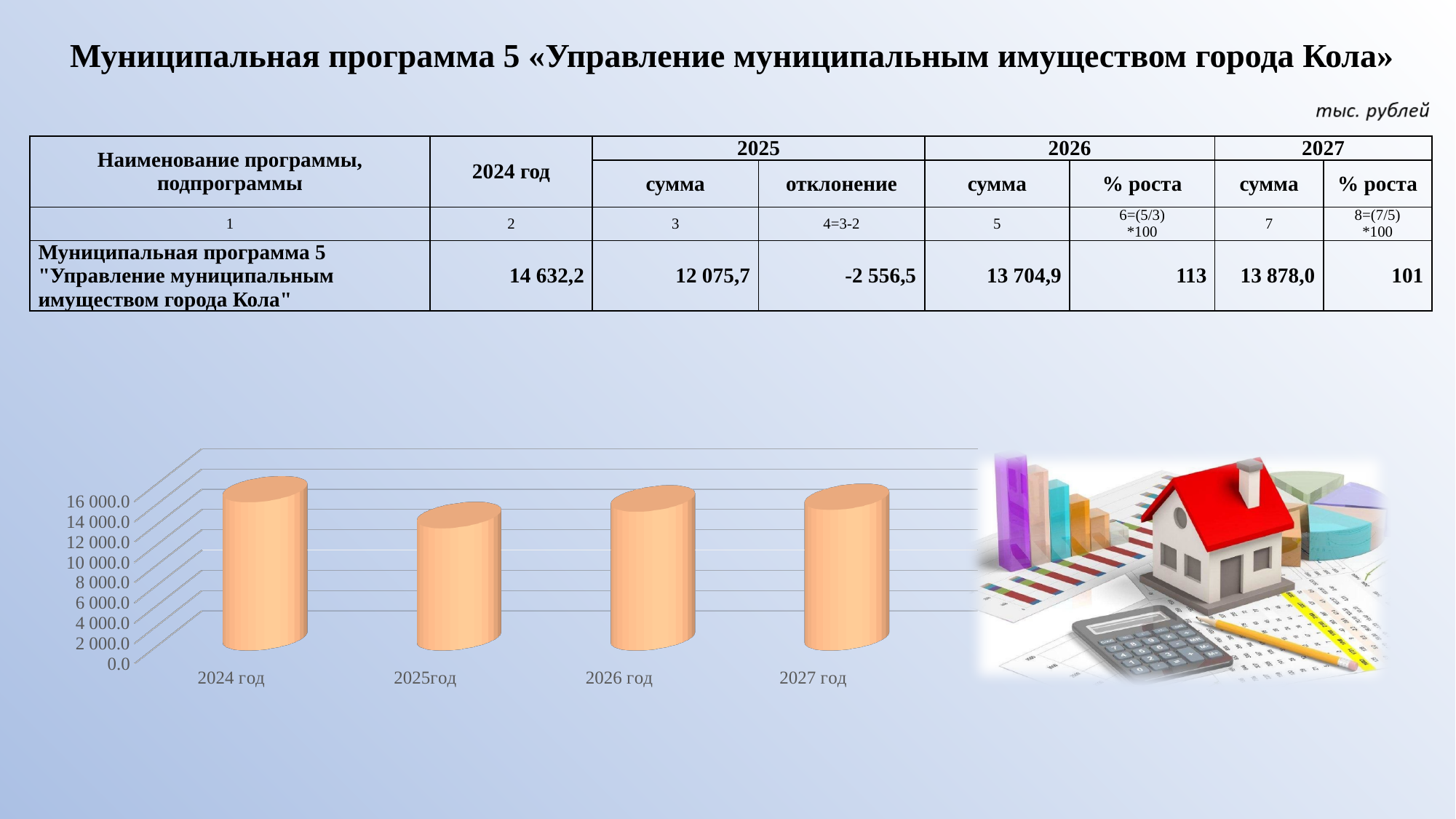
According to the table on the slide, what is the amount (сумма) for 2025 that the chart's 2025год bar represents? 12 075,7 Which bar is taller on the chart, 2025год or 2026 год? 2026 год Is the value for 2025год on the chart greater or less than 14 000.0? less Is the value for 2026 год on the chart greater or less than 12 000.0? greater What is the highest tick label shown on the chart's vertical axis? 16 000.0 Is the value for 2027 год on the chart greater or less than 16 000.0? less Which year has the highest bar on the chart? 2024 год How many categories (years) are plotted on the chart? 4 Which bar is taller on the chart, 2024 год or 2025год? 2024 год What kind of chart is shown on the slide? bar chart Which year has the lowest bar on the chart? 2025год